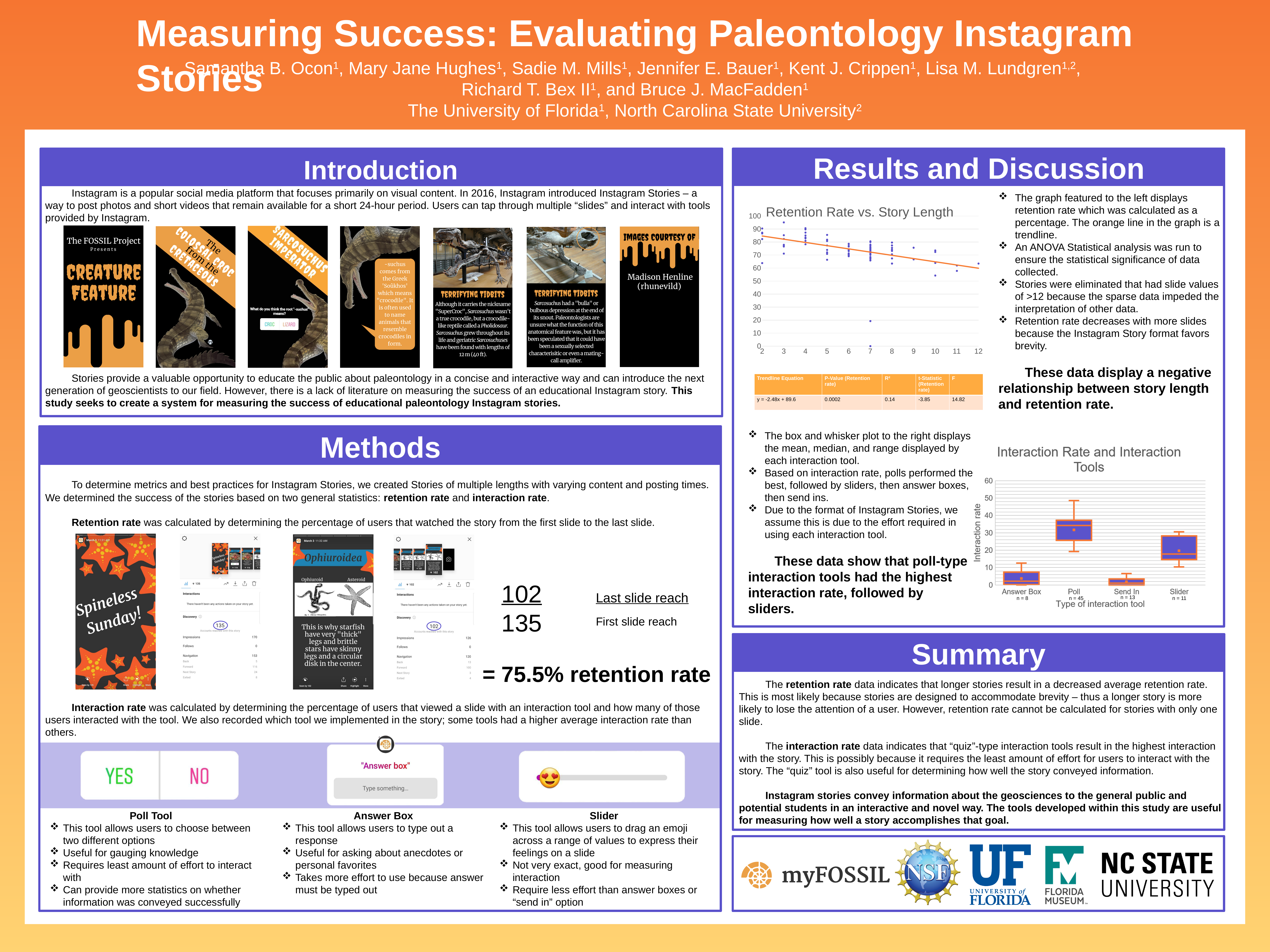
In the Interaction Rate and Interaction Tools chart, what is the sample size n for Answer Box? 8 What is the trendline equation shown for the Retention Rate vs. Story Length chart? y = -2.48x + 89.6 What kind of chart is the Interaction Rate and Interaction Tools chart? box and whisker plot In the Interaction Rate and Interaction Tools chart, what is the sample size n for Poll? 45 In the Retention Rate vs. Story Length chart, do retention rate values generally rise or fall as story length increases? fall In the Interaction Rate and Interaction Tools chart, which has the higher interaction rate, Poll or Slider? Poll In the Interaction Rate and Interaction Tools chart, is the median interaction rate for Slider greater or less than 20? less In the Interaction Rate and Interaction Tools chart, which interaction tool has the lowest interaction rate? Send In What is the title of the chart in the upper part of the Results and Discussion section? Retention Rate vs. Story Length In the Interaction Rate and Interaction Tools chart, which interaction tool has the highest interaction rate? Poll How many interaction tool categories are shown on the x axis of the Interaction Rate and Interaction Tools chart? 4 In the Retention Rate vs. Story Length chart, what is the highest story length value shown on the x axis? 12